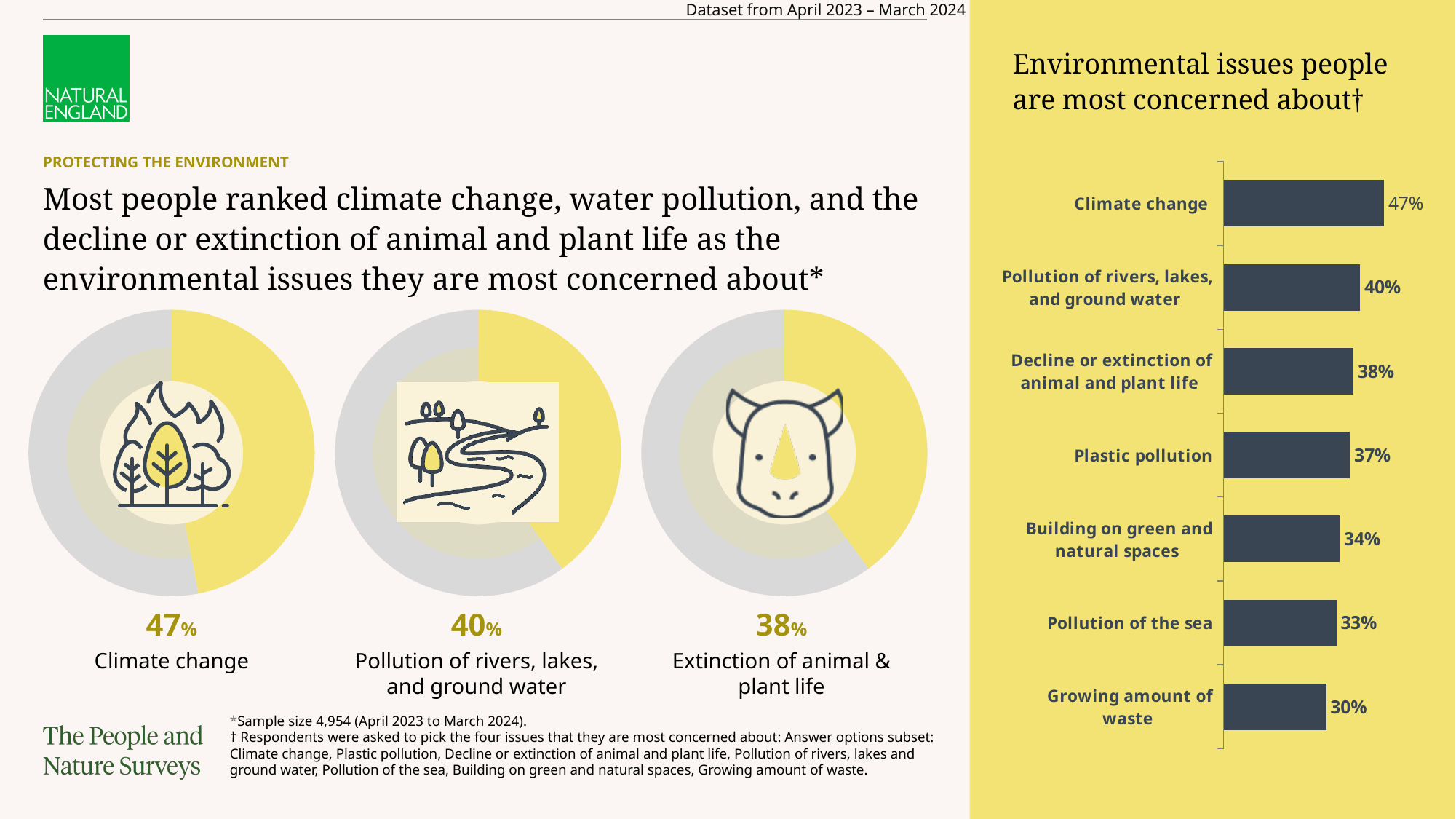
How many donut charts are shown on the left side of the slide? 3 In the bar chart titled 'Environmental issues people are most concerned about', what is the value for Building on green and natural spaces? 34% In the donut charts on the left of the slide, what percentage is shown for Extinction of animal & plant life? 38% How many categories are shown in the bar chart titled 'Environmental issues people are most concerned about'? 7 In the bar chart titled 'Environmental issues people are most concerned about', which category has the highest value? Climate change In the donut charts on the left of the slide, what percentage is shown for Climate change? 47% In the bar chart titled 'Environmental issues people are most concerned about', which category has the lowest value? Growing amount of waste In the bar chart titled 'Environmental issues people are most concerned about', which is larger: Pollution of rivers, lakes, and ground water or Plastic pollution? Pollution of rivers, lakes, and ground water In the bar chart titled 'Environmental issues people are most concerned about', what is the difference between Climate change and Growing amount of waste? 17% In the bar chart titled 'Environmental issues people are most concerned about', what is the value for Pollution of the sea? 33% In the bar chart titled 'Environmental issues people are most concerned about', what is the value for Plastic pollution? 37% What kind of chart is the chart titled 'Environmental issues people are most concerned about'? Bar chart